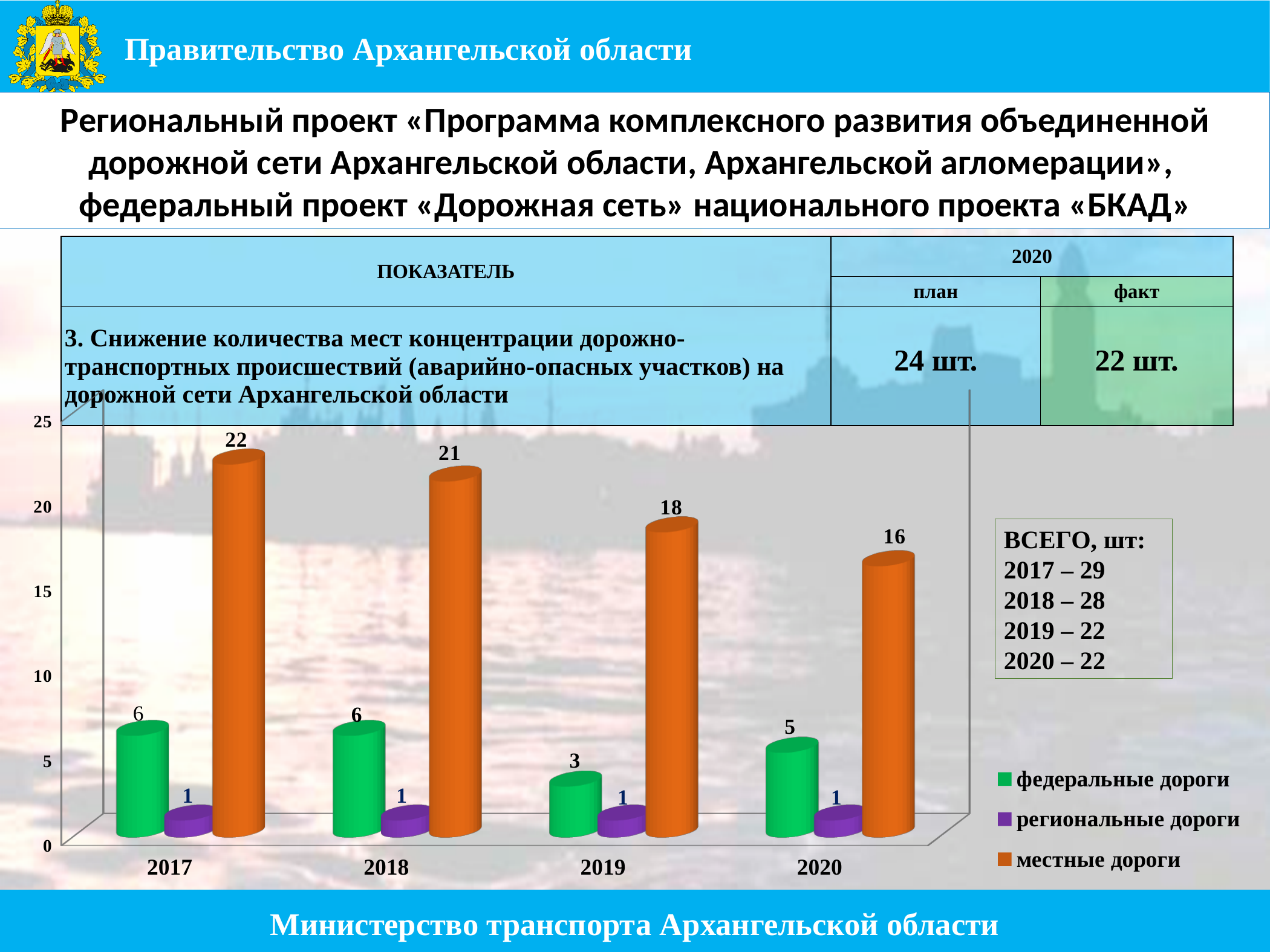
Which is larger: федеральные дороги in 2018 or федеральные дороги in 2020? федеральные дороги in 2018 What is the value for местные дороги in 2017? 22 What is the value for федеральные дороги in 2019? 3 How many series does the chart legend list? 3 Do the values for местные дороги rise or fall from 2017 to 2020? fall Is the value for местные дороги in 2019 greater or less than 15? greater What kind of chart is shown on the slide? bar chart How many years are shown on the x axis of the chart? 4 In which year is the value for федеральные дороги the lowest? 2019 In which year is the value for местные дороги the highest? 2017 What is the difference between the местные дороги values for 2017 and 2020? 6 What is the value for региональные дороги in 2020? 1